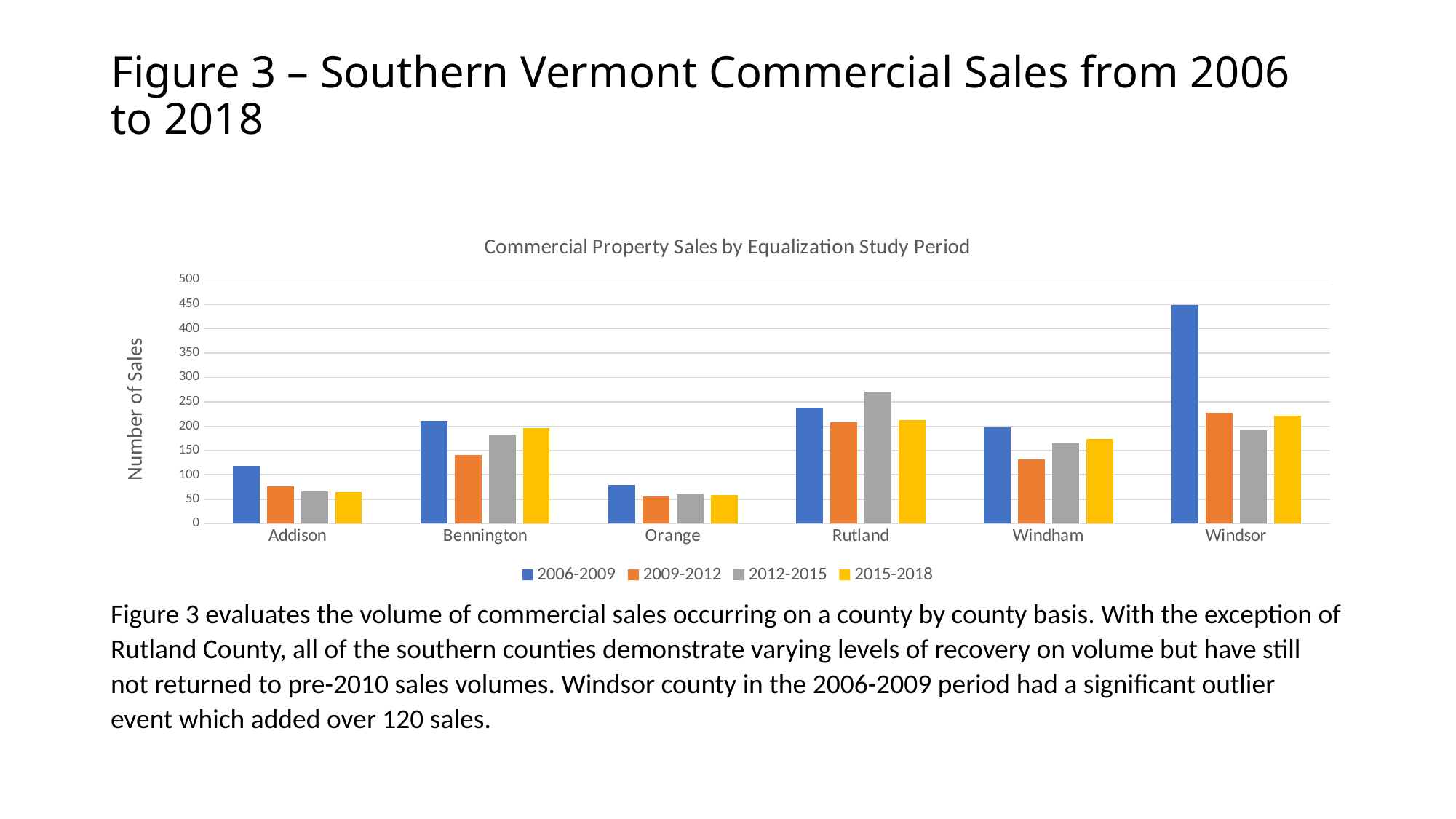
How many series does the legend list? 4 Which county has the highest value for the 2006-2009 series? Windsor Which county has the highest value for the 2012-2015 series? Rutland What is the title of the chart? Commercial Property Sales by Equalization Study Period Is the value for Windsor in 2006-2009 greater or less than 400? greater For Windham, which is larger: the 2009-2012 value or the 2015-2018 value? 2015-2018 Is the value for Orange in 2006-2009 greater or less than 100? less How many counties are shown on the x axis? 6 For Rutland, which is larger: the 2006-2009 value or the 2012-2015 value? 2012-2015 Which county has the lowest value for the 2006-2009 series? Orange Is the value for Rutland in 2012-2015 greater or less than 250? greater What kind of chart is shown on the slide? Bar chart